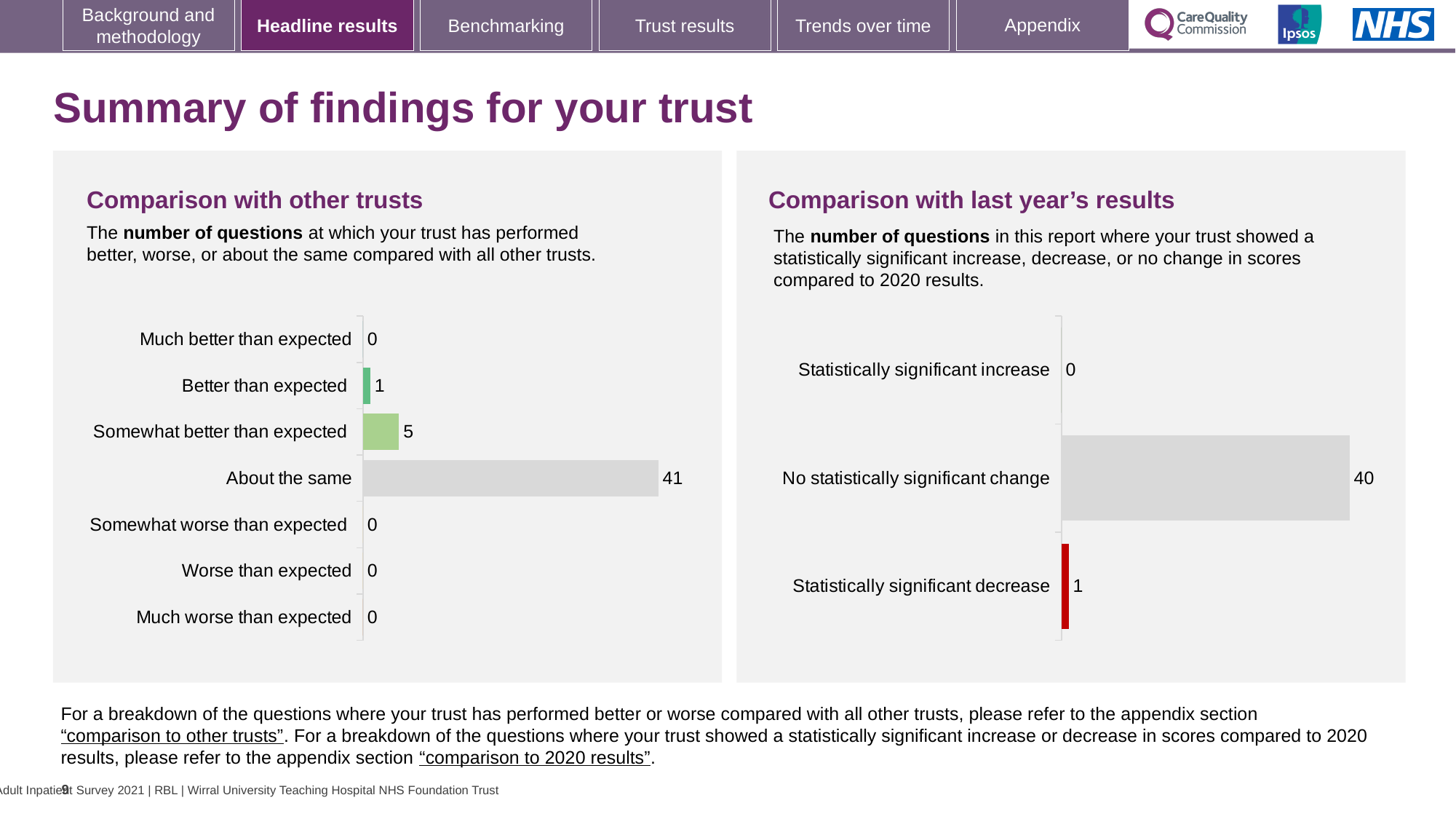
In the 'Comparison with other trusts' chart, how many questions are 'Better than expected'? 1 What type of chart is the 'Comparison with other trusts' chart? Bar chart In the 'Comparison with other trusts' chart, which category has the highest value? About the same In the 'Comparison with last year's results' chart, how many questions showed 'No statistically significant change'? 40 In the 'Comparison with last year's results' chart, how many questions showed a 'Statistically significant decrease'? 1 In the 'Comparison with other trusts' chart, how many questions are 'About the same'? 41 In the 'Comparison with last year's results' chart, how many questions showed a 'Statistically significant increase'? 0 In the 'Comparison with other trusts' chart, how many categories are shown? 7 In the 'Comparison with last year's results' chart, how many categories are shown? 3 In the 'Comparison with other trusts' chart, how many questions are 'Somewhat better than expected'? 5 In the 'Comparison with last year's results' chart, which is larger: 'Statistically significant decrease' or 'Statistically significant increase'? Statistically significant decrease In the 'Comparison with other trusts' chart, what is the difference between 'About the same' and 'Somewhat better than expected'? 36